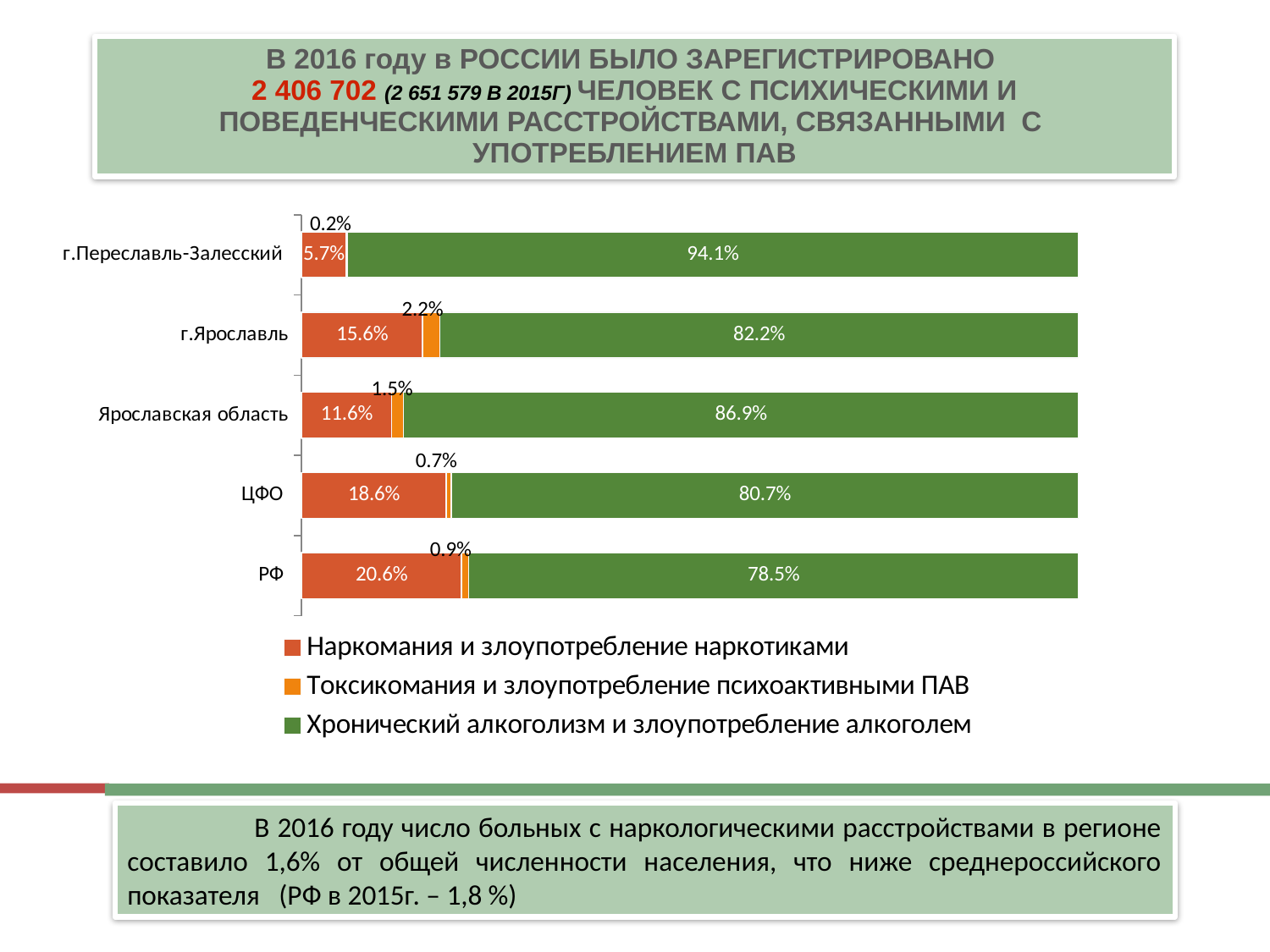
How many categories are shown on the chart? 5 Which category has the lowest value for Наркомания и злоупотребление наркотиками? г.Переславль-Залесский What is the value for Хронический алкоголизм и злоупотребление алкоголем for г.Переславль-Залесский? 94.1% What kind of chart is shown on the slide? Stacked bar chart Which category has the highest value for Хронический алкоголизм и злоупотребление алкоголем? г.Переславль-Залесский What is the value for Наркомания и злоупотребление наркотиками for Ярославская область? 11.6% What is the value for Токсикомания и злоупотребление психоактивными ПАВ for г.Ярославль? 2.2% How many series does the legend list? 3 What is the difference between the Хронический алкоголизм и злоупотребление алкоголем values for Ярославская область and РФ? 8.4% What is the value for Наркомания и злоупотребление наркотиками for РФ? 20.6% Which is larger: the Наркомания и злоупотребление наркотиками value for ЦФО or for г.Ярославль? ЦФО Which colour represents Токсикомания и злоупотребление психоактивными ПАВ in the chart? Orange